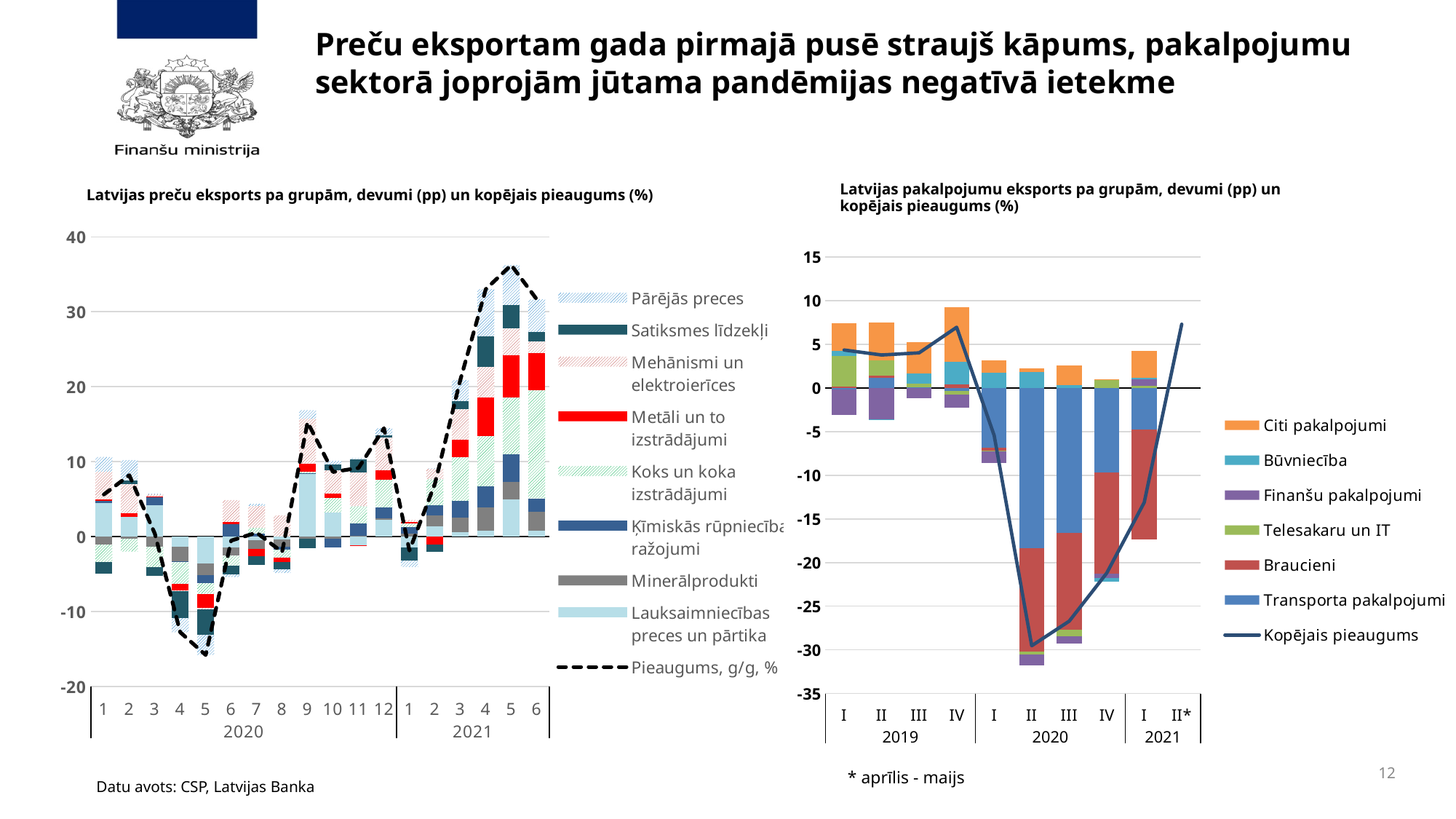
How many entries does the legend of the right chart, 'Latvijas pakalpojumu eksports pa grupām', list? 7 In the left chart, 'Latvijas preču eksports pa grupām', is the 'Pieaugums, g/g, %' value for month 5 of 2021 greater or less than 30? greater In the right chart, 'Latvijas pakalpojumu eksports pa grupām', what does the footnote asterisk on II* 2021 stand for? aprīlis - maijs In the right chart, 'Latvijas pakalpojumu eksports pa grupām', in which period does the 'Kopējais pieaugums' line reach its lowest point? II 2020 What kind of chart is the left chart, 'Latvijas preču eksports pa grupām'? Stacked bar chart with a line How many periods (bars) are shown on the x axis of the right chart, 'Latvijas pakalpojumu eksports pa grupām'? 10 In the right chart, 'Latvijas pakalpojumu eksports pa grupām', does the 'Kopējais pieaugums' line rise or fall from II 2020 to II* 2021? rise In the left chart, 'Latvijas preču eksports pa grupām', in which month does the 'Pieaugums, g/g, %' line reach its highest point? 5 2021 In the right chart, 'Latvijas pakalpojumu eksports pa grupām', in which period does the 'Kopējais pieaugums' line reach its highest point? II* 2021 How many months are shown on the x axis of the left chart, 'Latvijas preču eksports pa grupām'? 18 In the right chart, 'Latvijas pakalpojumu eksports pa grupām', is the 'Kopējais pieaugums' value for II 2020 greater or less than -25? less How many entries does the legend of the left chart, 'Latvijas preču eksports pa grupām', list? 9